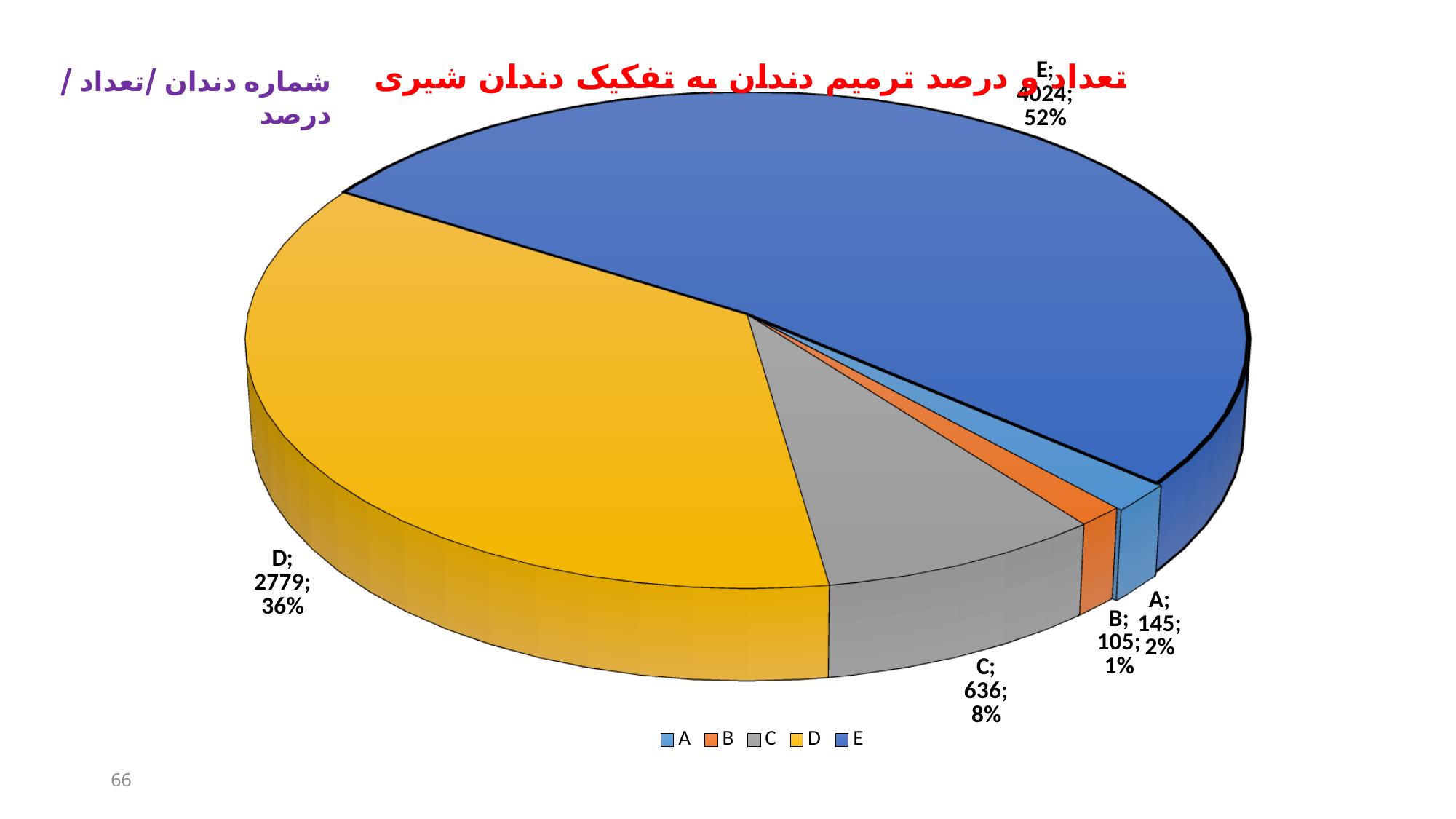
Which slice is the smallest? B Which has a larger count, slice A or slice B? A What is the count value shown for slice A? 145 What percentage share does slice B have? 1% How many entries does the legend list? 5 What percentage share does slice D have? 36% What is the count value shown for slice C? 636 How many slices does the pie chart have? 5 Which slice is the largest? E What is the count value shown for slice E? 4024 What kind of chart is shown on the slide? pie chart What is the difference between the count for E and the count for D? 1245